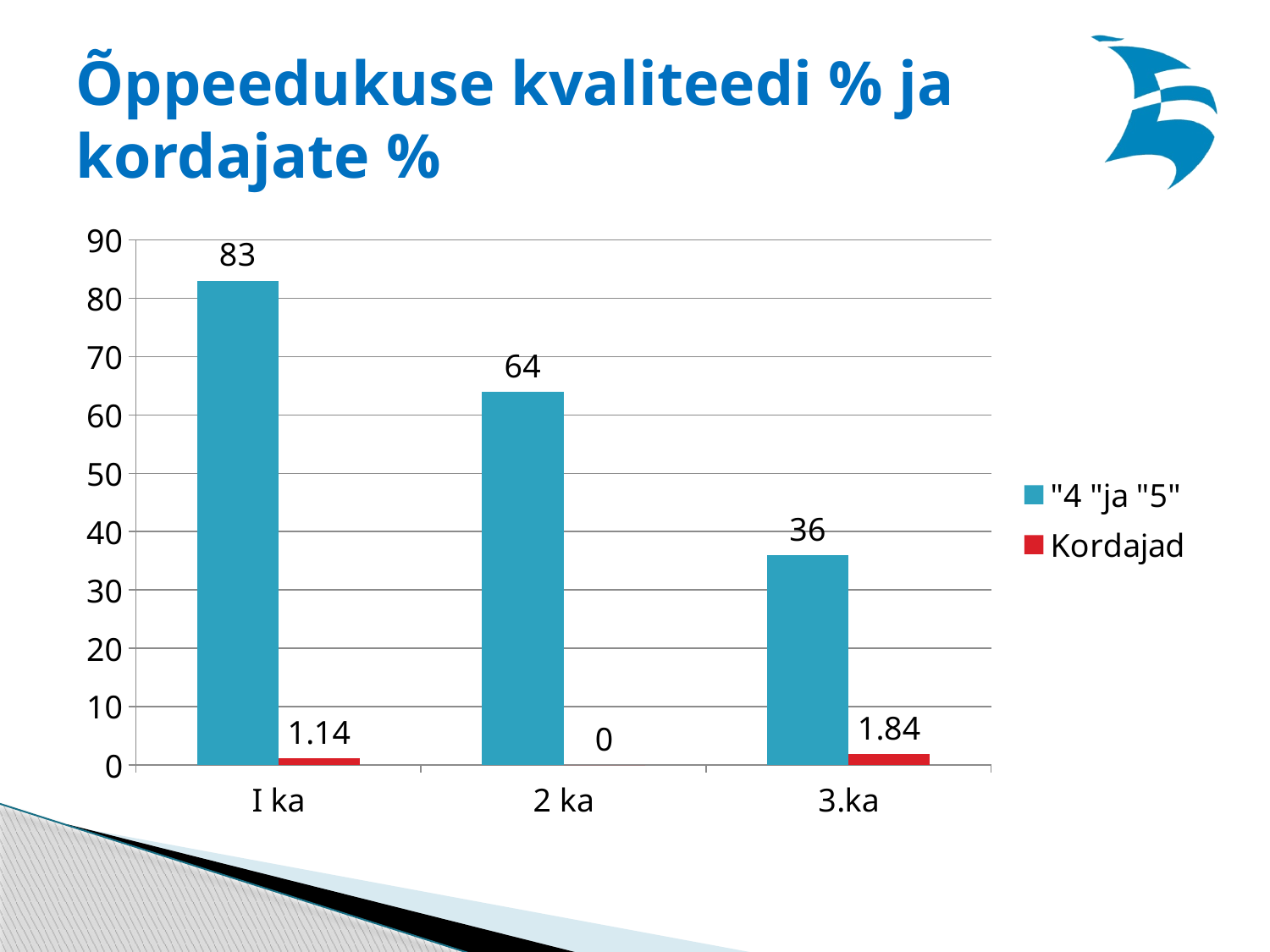
How many categories are shown on the x axis? 3 What kind of chart is shown on the slide? bar chart Which category has the highest value for the "4 "ja "5" series? I ka What is the value of the Kordajad series for 3.ka? 1.84 Which is larger: the Kordajad value for I ka or for 3.ka? 3.ka Is the "4 "ja "5" value for 3.ka greater or less than 40? less How many series does the legend list? 2 What is the difference between the "4 "ja "5" values for I ka and 3.ka? 47 What is the value of the "4 "ja "5" series for I ka? 83 What is the value of the "4 "ja "5" series for 2 ka? 64 What is the value of the Kordajad series for 2 ka? 0 Which category has the lowest value for the Kordajad series? 2 ka